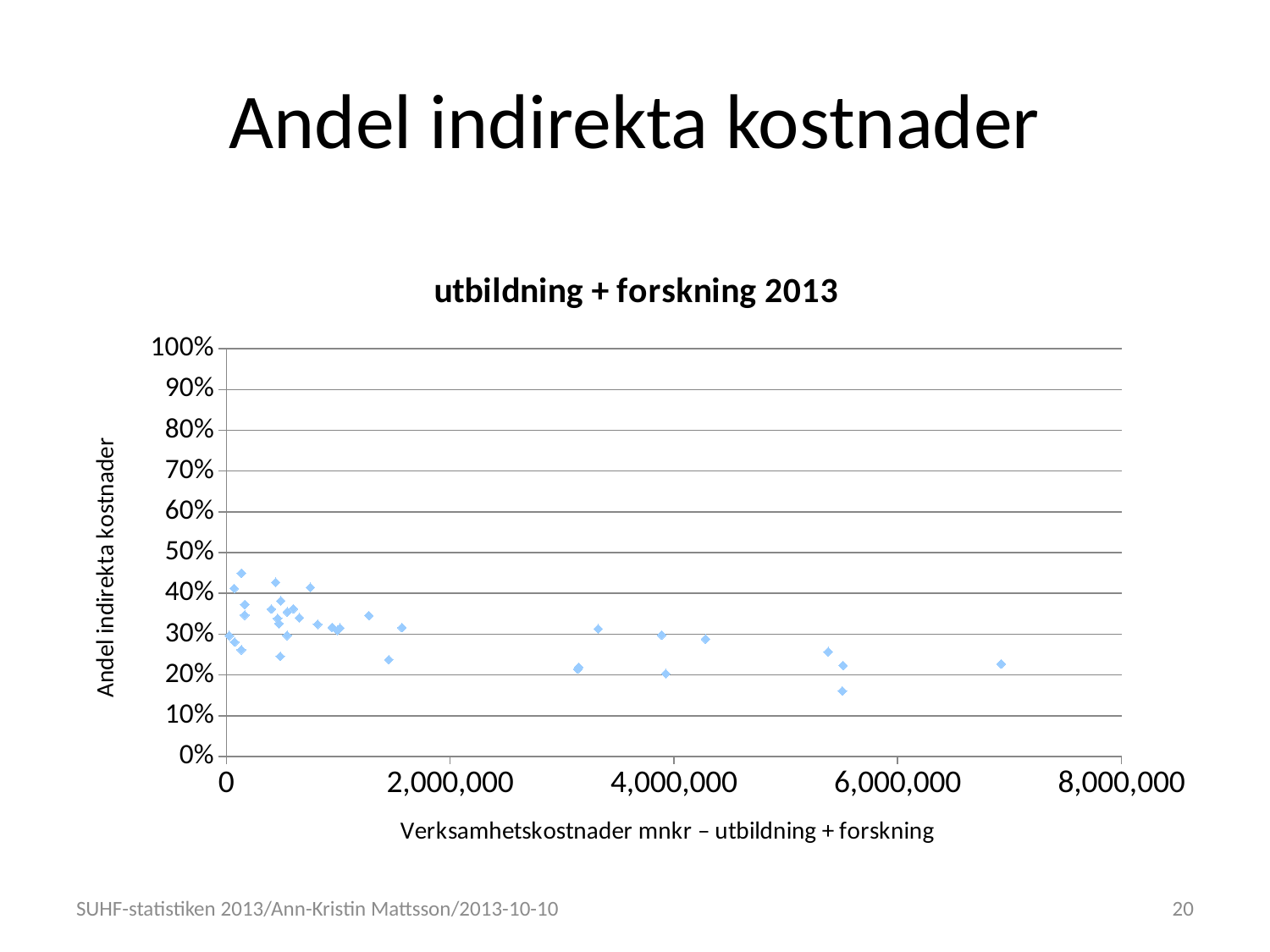
Is the value for the rightmost point (near 7,000,000 on the x axis) greater or less than 30%? less Is the point near 4,200,000 on the x axis greater or less than 20%? greater Do the plotted values generally rise or fall as the x-axis value (Verksamhetskostnader) increases? fall Is the value for the lowest point on the chart greater or less than 20%? less What kind of chart is shown on the slide? scatter chart Are there any points plotted beyond 8,000,000 on the x axis? no What is the label of the vertical axis? Andel indirekta kostnader What is the title of the chart? utbildning + forskning 2013 Is the highest point located in the left part of the chart (below 2,000,000 on the x axis) or the right part? left part